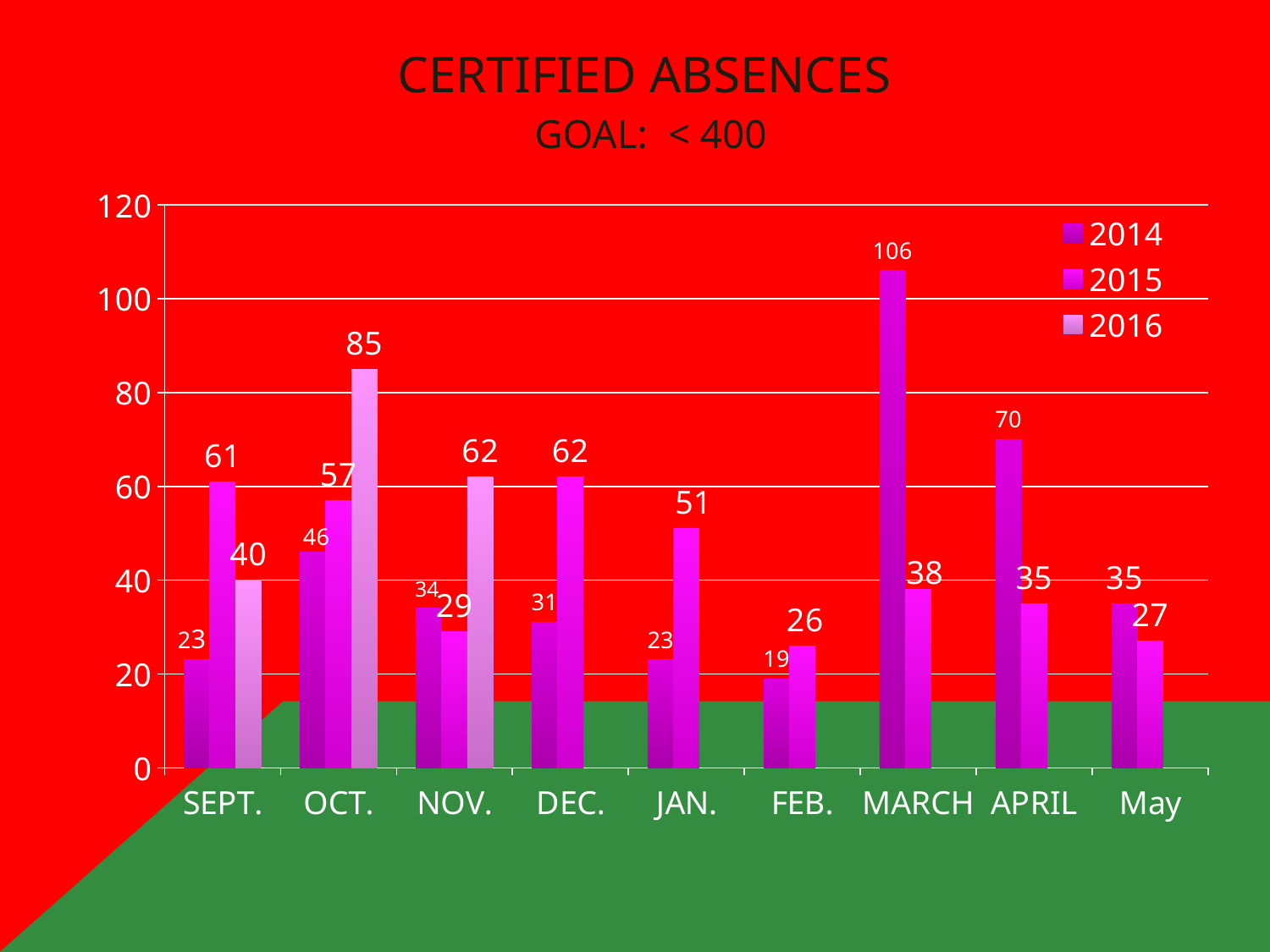
How many series does the legend list? 3 Which month has the highest value for the 2014 series? MARCH What is the value for 2014 in MARCH? 106 Which is larger in NOV., the 2014 value or the 2015 value? 2014 Which month has the lowest value for the 2014 series? FEB. How many months are shown on the x axis? 9 What is the value for 2015 in JAN.? 51 What goal is stated in the chart subtitle? < 400 What is the difference between the 2014 and 2015 values in MARCH? 68 What is the value for 2016 in OCT.? 85 What kind of chart is shown on the slide? bar chart